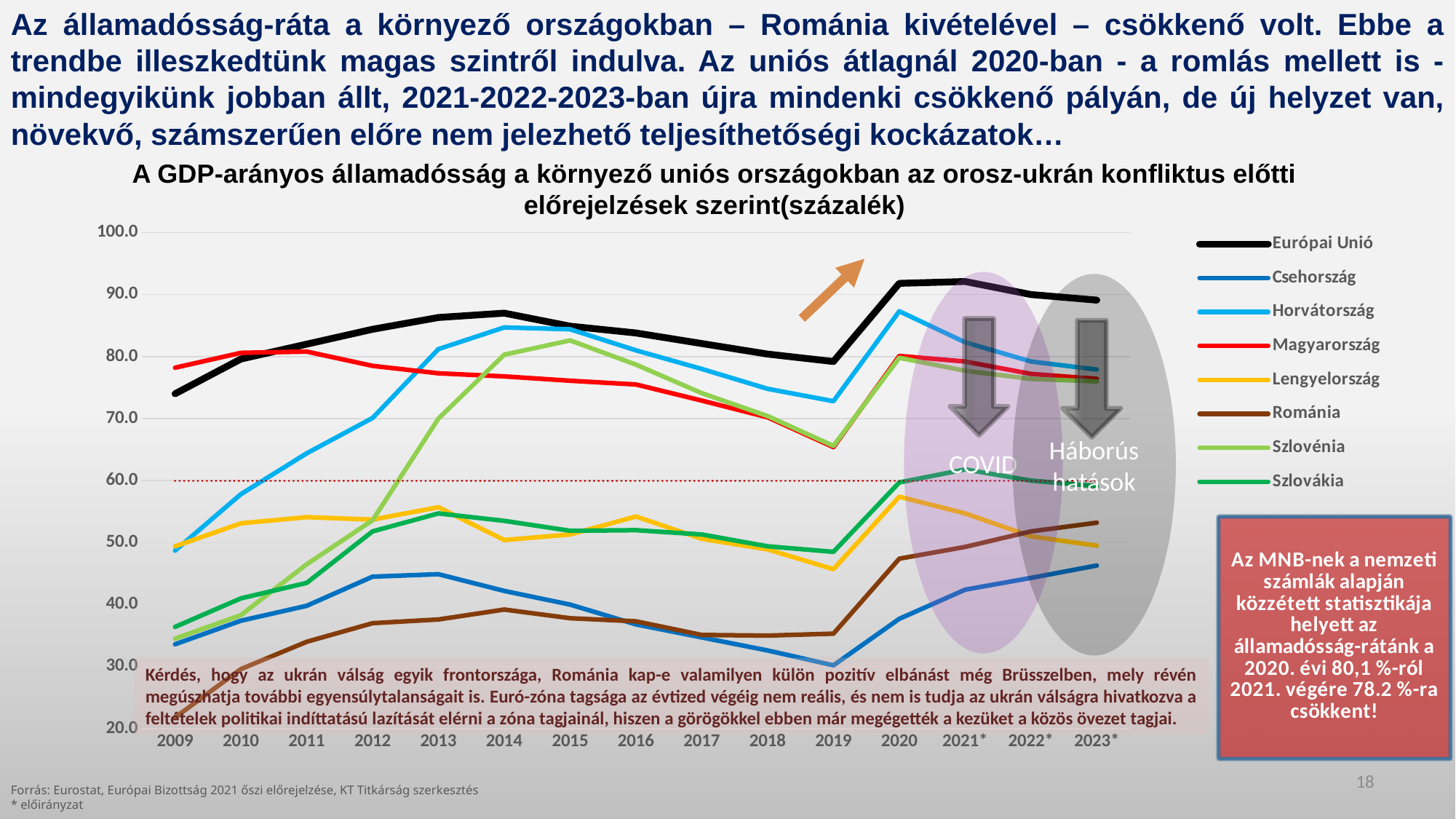
How many series does the chart legend list? 8 How many years are shown along the x axis of the chart? 15 Which country has the lowest debt ratio in 2009? Románia Is the value for Csehország in 2019 greater or less than 40? less Which country or region has the highest debt ratio in 2020? Európai Unió What colour is the Magyarország line in the chart? red Is the value for Európai Unió in 2020 greater or less than 90? greater Is the value for Magyarország in 2019 greater or less than 70? less What kind of chart is shown on the slide? line chart Does the Európai Unió line rise or fall from 2009 to 2014? rise In 2014, which is larger: the value for Horvátország or for Magyarország? Horvátország